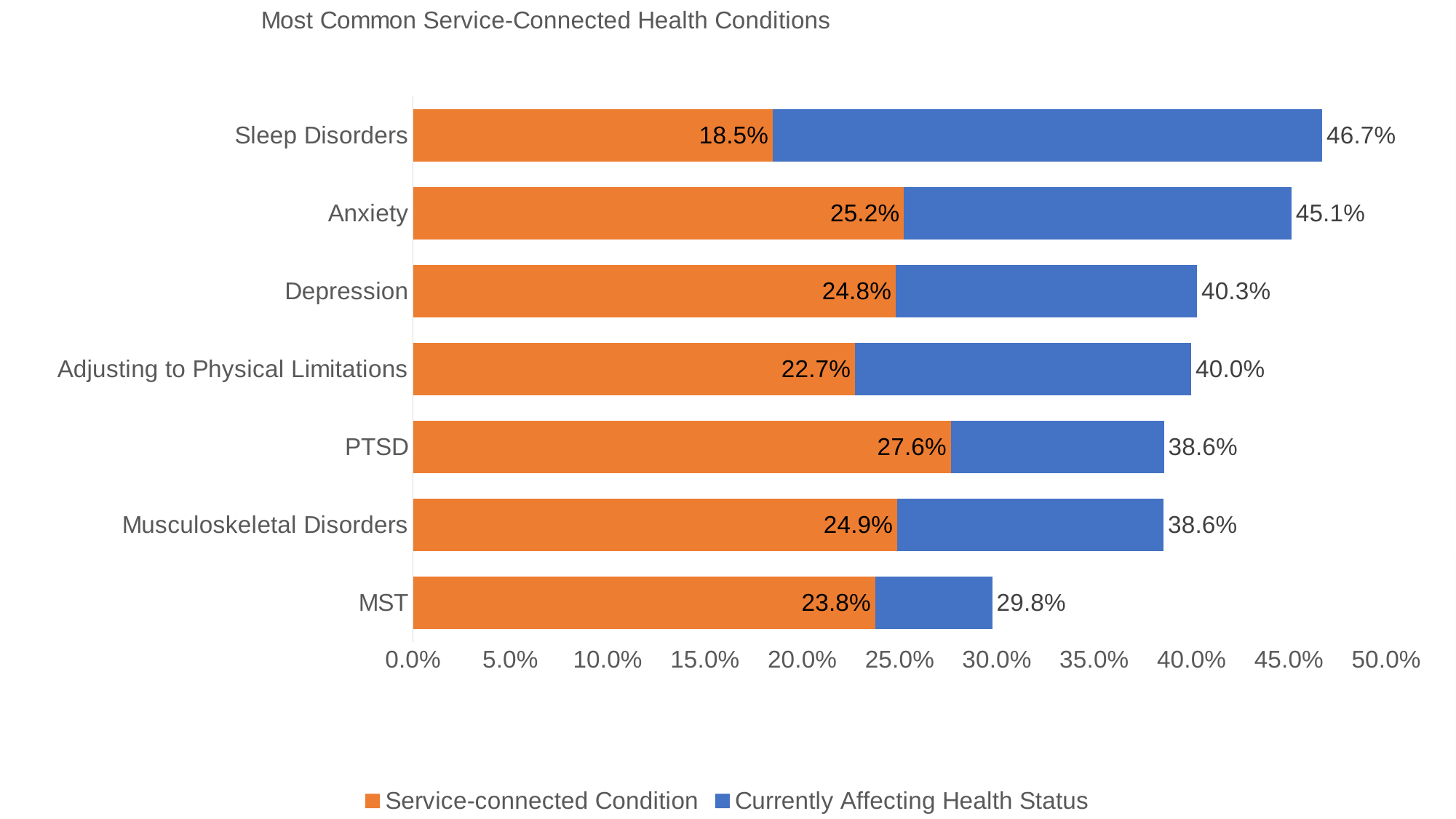
Which condition has the highest Currently Affecting Health Status value? Sleep Disorders What is the title of the chart? Most Common Service-Connected Health Conditions What is the difference between the Currently Affecting Health Status values for Sleep Disorders and Anxiety? 1.6 percentage points What is the Currently Affecting Health Status value for Sleep Disorders? 46.7% What is the Service-connected Condition value for MST? 23.8% Which has a larger Service-connected Condition value, PTSD or Depression? PTSD What is the Service-connected Condition value for PTSD? 27.6% What kind of chart is shown on the slide? Bar chart How many series does the legend list? 2 Which condition has the lowest Currently Affecting Health Status value? MST How many health conditions are shown in the chart? 7 Which condition has the lowest Service-connected Condition value? Sleep Disorders